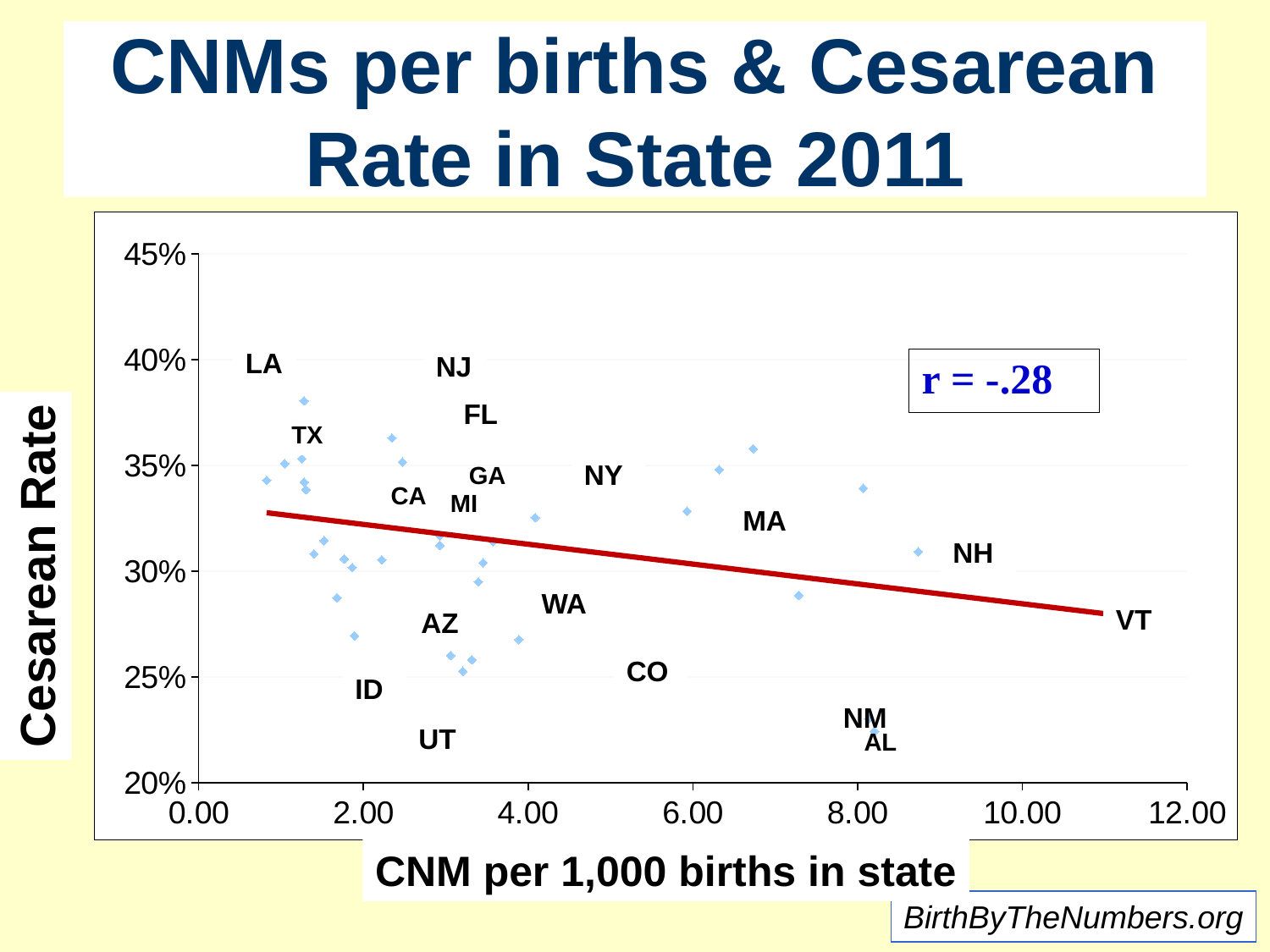
What is the minimum value shown on the y axis? 20% What is the title of the chart? CNMs per births & Cesarean Rate in State 2011 What is the label of the x axis? CNM per 1,000 births in state What kind of chart is shown on the slide? Scatter plot What is the maximum value shown on the y axis? 45% Is the cesarean rate of the highest point on the chart greater or less than 35%? greater Is the correlation between CNMs per births and cesarean rate positive or negative? Negative Does the red trend line rise or fall as CNM per 1,000 births increases? Falls Is the cesarean rate of the lowest point on the chart greater or less than 25%? less What correlation coefficient (r) is shown on the chart? r = -.28 What is the maximum value shown on the x axis? 12.00